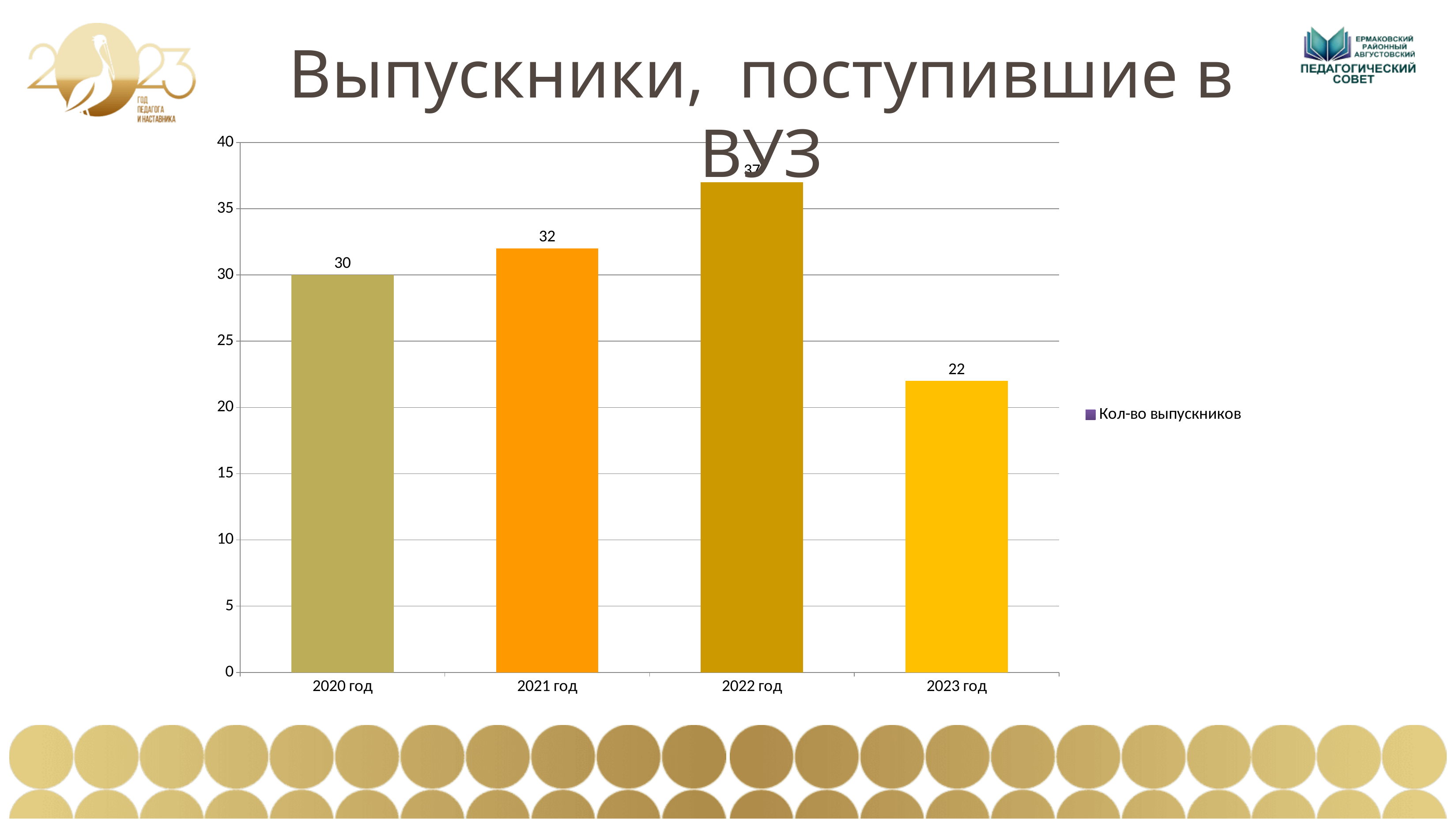
Which is larger, the value for 2021 год or the value for 2023 год? 2021 год What is the value for 2021 год? 32 Which year has the lowest value? 2023 год What is the value for 2022 год? 37 How many years are shown on the x axis? 4 What is the value for 2020 год? 30 Is the value for 2022 год greater or less than 35? greater What is the value for 2023 год? 22 What type of chart is shown on the slide? bar chart Which year has the highest value? 2022 год What is the difference between the values for 2020 год and 2023 год? 8 What is the difference between the values for 2021 год and 2020 год? 2